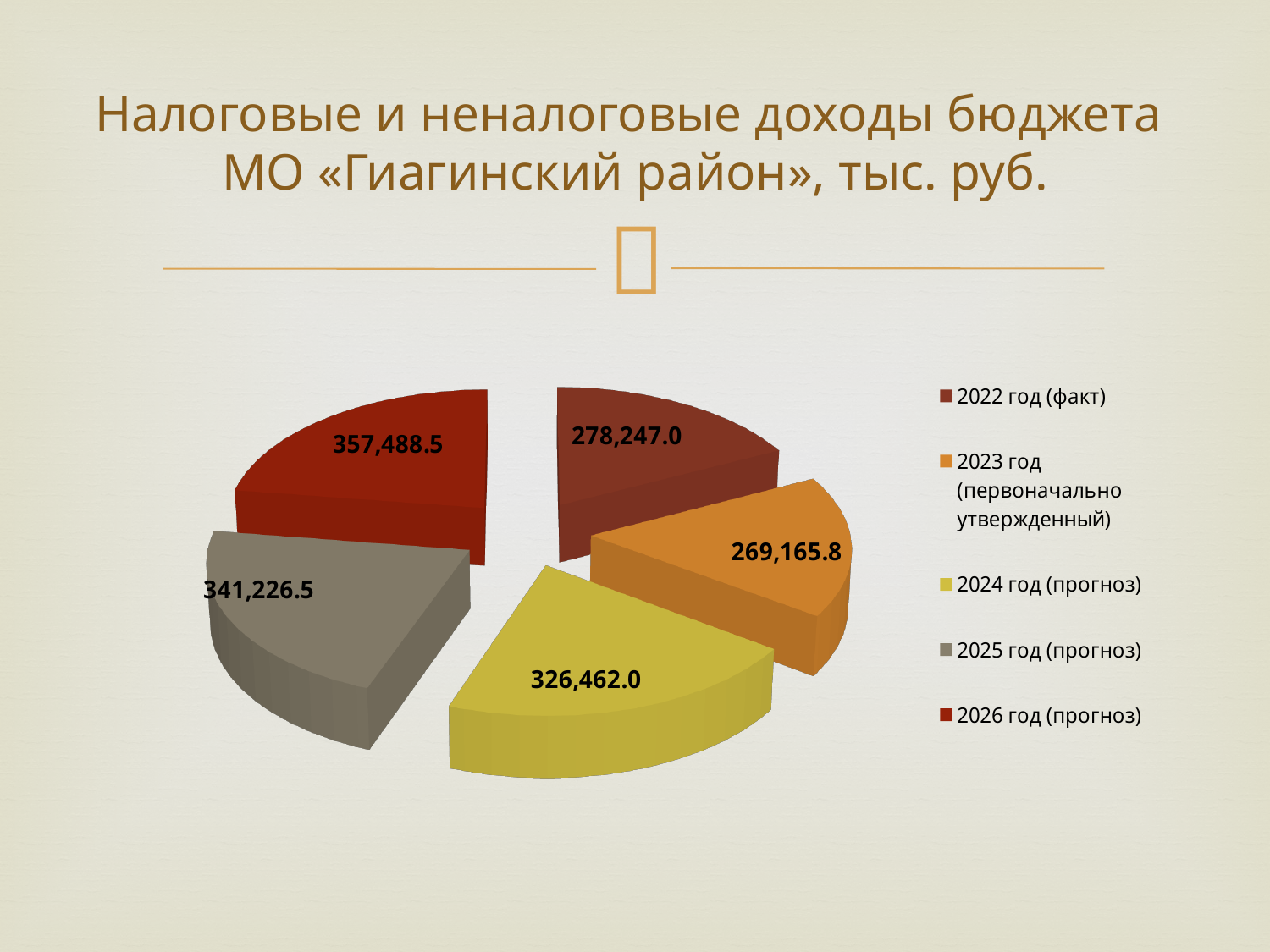
What is the value for 2022 год (факт)? 278,247.0 What is the value for 2023 год (первоначально утвержденный)? 269,165.8 What colour is the slice for 2024 год (прогноз)? Yellow Which year has the smallest value in the pie chart? 2023 год (первоначально утвержденный) What is the value for 2025 год (прогноз)? 341,226.5 What kind of chart is shown on the slide? Pie chart What is the difference between the values for 2026 год (прогноз) and 2022 год (факт)? 79,241.5 How many slices does the pie chart have? 5 What is the difference between the values for 2025 год (прогноз) and 2024 год (прогноз)? 14,764.5 Which is larger: the value for 2024 год (прогноз) or the value for 2022 год (факт)? 2024 год (прогноз) Which year has the largest value in the pie chart? 2026 год (прогноз) What is the total of all the values shown in the pie chart? 1,572,589.8